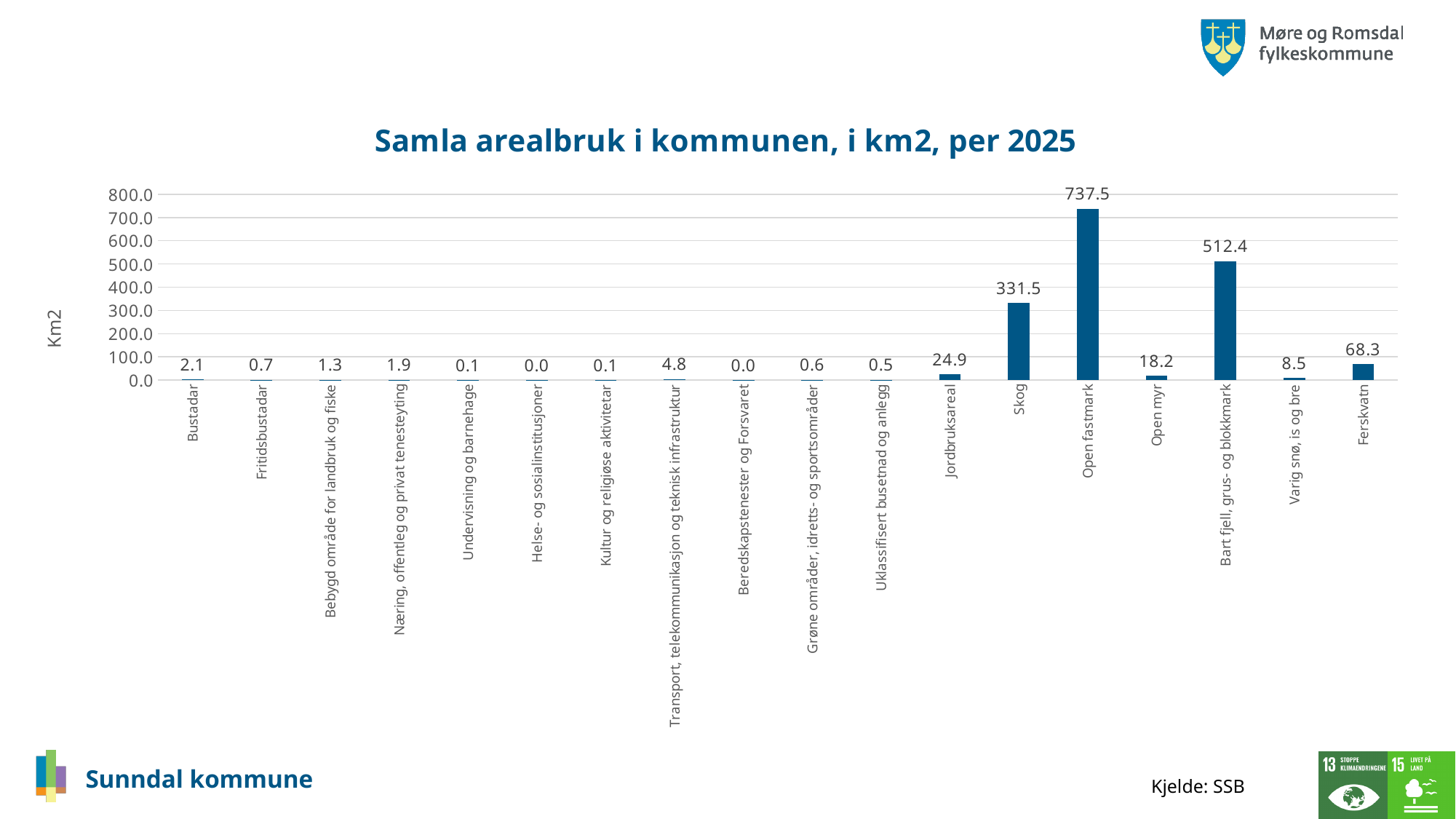
What is the value for Skog? 331.5 What is the value for Ferskvatn? 68.3 What is the value for Jordbruksareal? 24.9 What is the title of the chart? Samla arealbruk i kommunen, i km2, per 2025 What is the difference between Skog and Ferskvatn? 263.2 What is the value for Open fastmark? 737.5 Is the value for Bart fjell, grus- og blokkmark greater or less than 500.0? greater Which is larger, Open myr or Varig snø, is og bre? Open myr What is the difference between Open fastmark and Bart fjell, grus- og blokkmark? 225.1 What kind of chart is shown? Bar chart Which category has the highest value? Open fastmark How many categories are shown on the x axis? 18